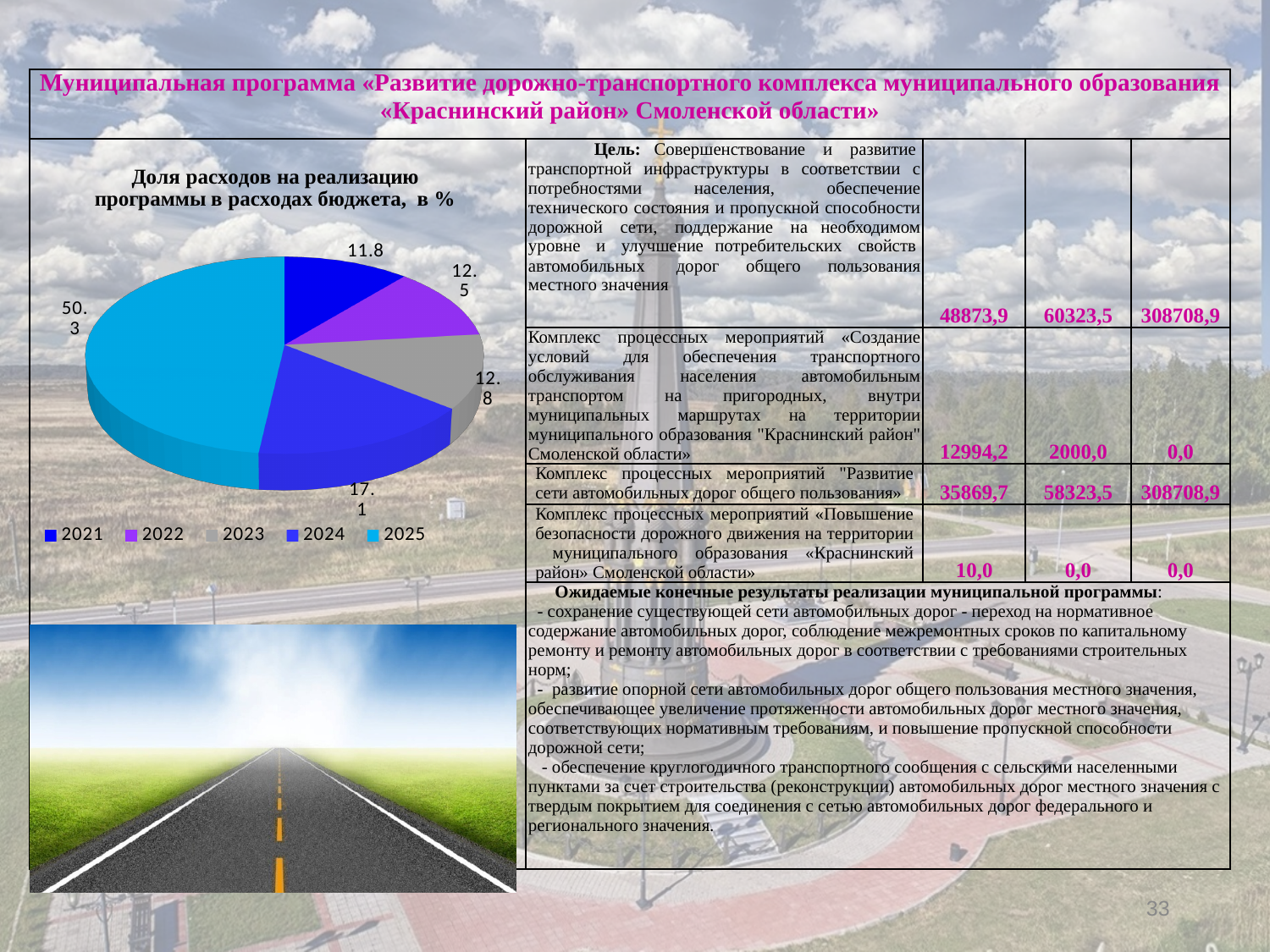
What is the value for 2022 in the pie chart? 12.5 What is the value for 2023 in the pie chart? 12.8 What is the value for 2024 in the pie chart? 17.1 Which is larger in the pie chart, the value for 2024 or the value for 2023? 2024 What is the title of the chart on the slide? Доля расходов на реализацию программы в расходах бюджета, в % Which year has the smallest slice in the pie chart? 2021 What is the difference between the values for 2025 and 2024 in the pie chart? 33.2 What is the value for 2025 in the pie chart? 50.3 What is the value for 2021 in the pie chart? 11.8 Which year has the largest slice in the pie chart? 2025 How many categories does the legend of the pie chart list? 5 What type of chart is shown on the slide? pie chart